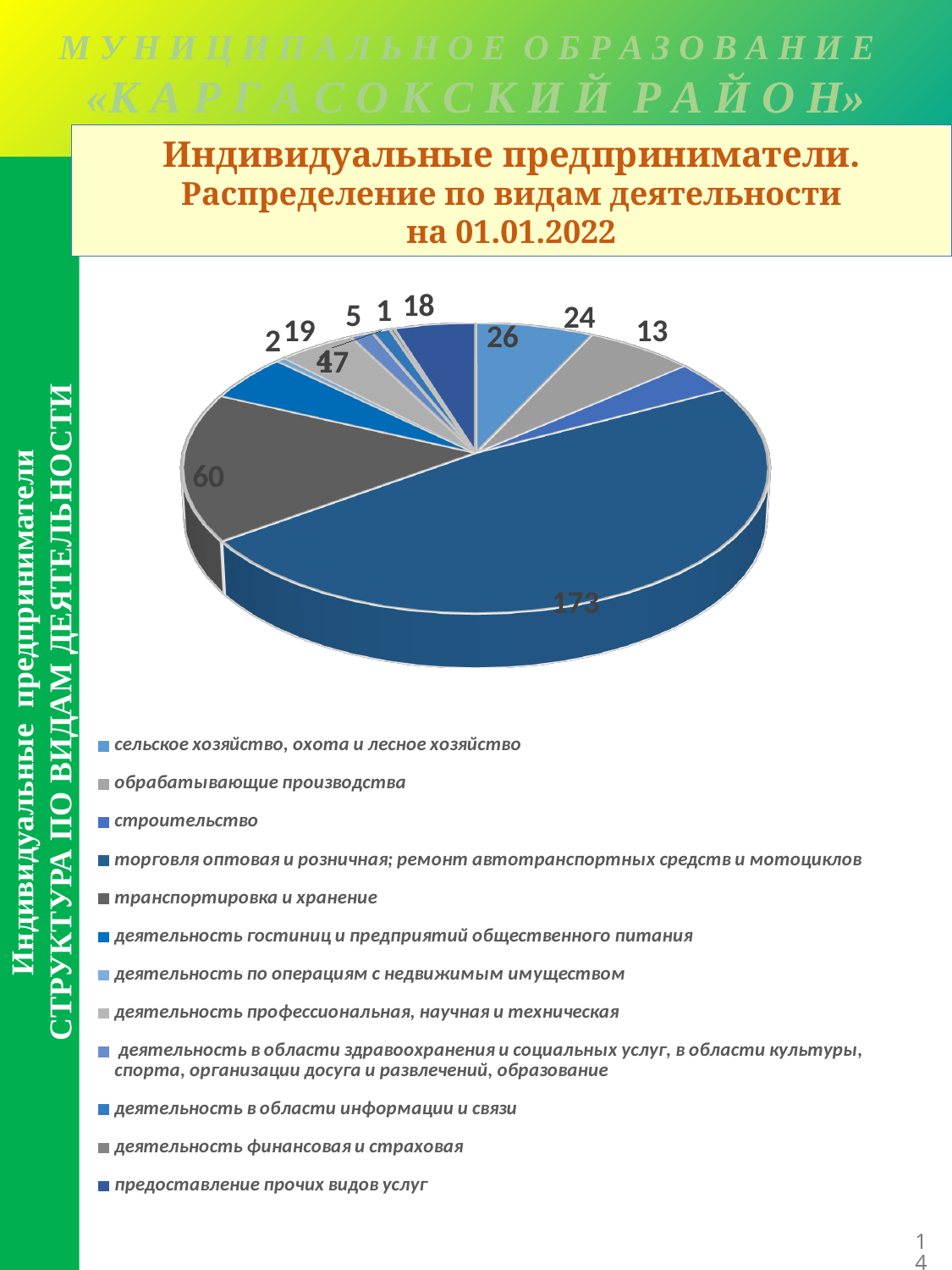
Which category has the largest slice in the pie chart? торговля оптовая и розничная; ремонт автотранспортных средств и мотоциклов What is the value shown for 'строительство'? 13 As of what date does the chart show the distribution of individual entrepreneurs by type of activity? 01.01.2022 How many categories does the legend of the pie chart list? 12 What is the smallest value printed as a data label on the pie chart? 1 Which is larger: the value for 'транспортировка и хранение' or the value for 'сельское хозяйство, охота и лесное хозяйство'? транспортировка и хранение What is the value shown for 'сельское хозяйство, охота и лесное хозяйство'? 26 What is the difference between the values for 'торговля оптовая и розничная; ремонт автотранспортных средств и мотоциклов' and 'транспортировка и хранение'? 113 What is the value of the largest slice in the pie chart? 173 What kind of chart is shown on the slide? pie chart What is the value shown for 'обрабатывающие производства'? 24 What is the value shown for 'транспортировка и хранение'? 60